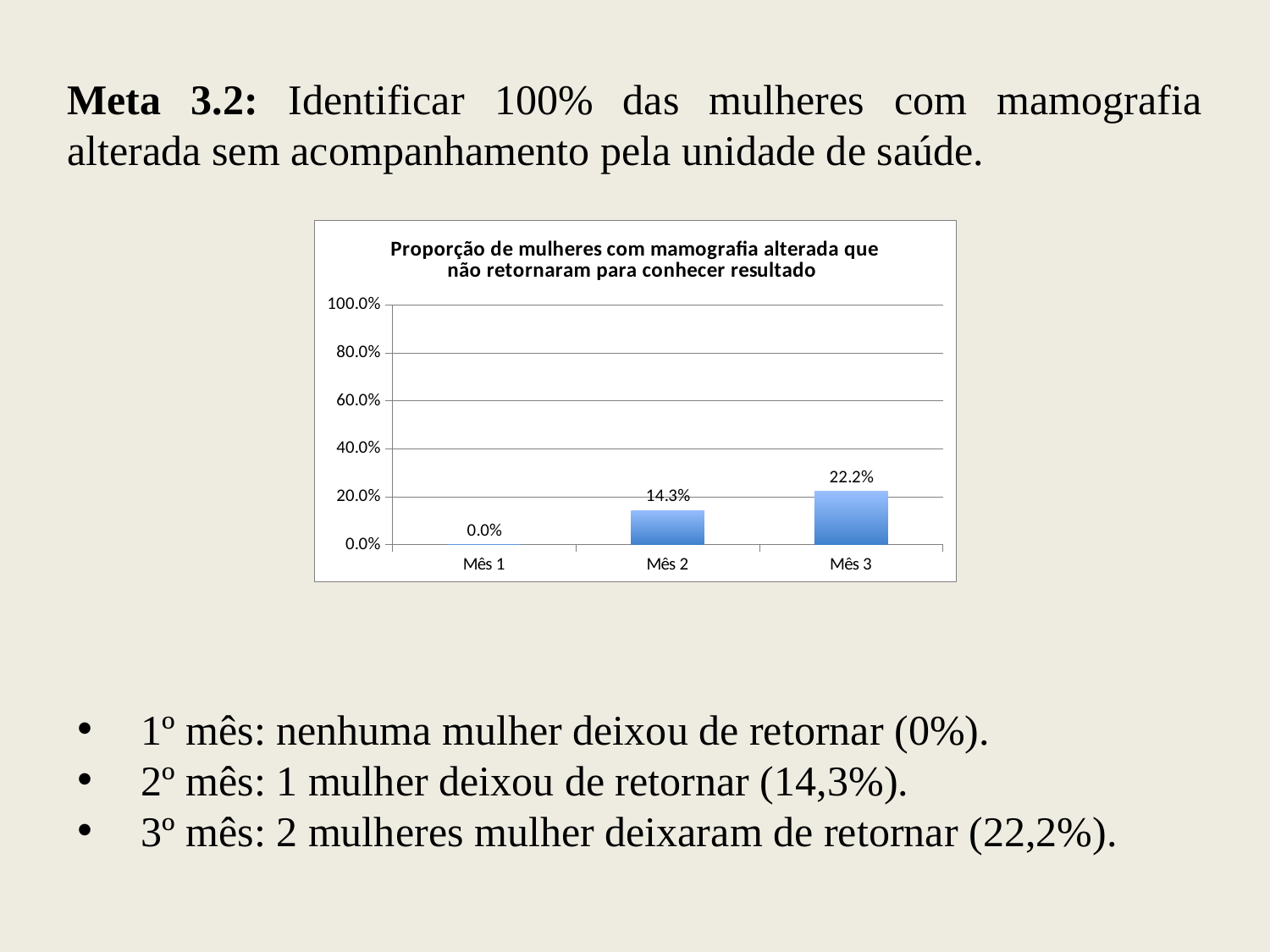
What is the value for Mês 3? 22.2% What is the value for Mês 2? 14.3% What is the difference between the values for Mês 3 and Mês 2? 7.9% Which month has the lowest value? Mês 1 What kind of chart is shown? Bar chart Is the value for Mês 3 greater or less than 40.0%? less Do the values rise or fall from Mês 1 to Mês 3? Rise Which month has the highest value? Mês 3 Which is larger, the value for Mês 2 or Mês 3? Mês 3 How many months are shown on the x axis? 3 What is the value for Mês 1? 0.0% What is the title of the chart? Proporção de mulheres com mamografia alterada que não retornaram para conhecer resultado